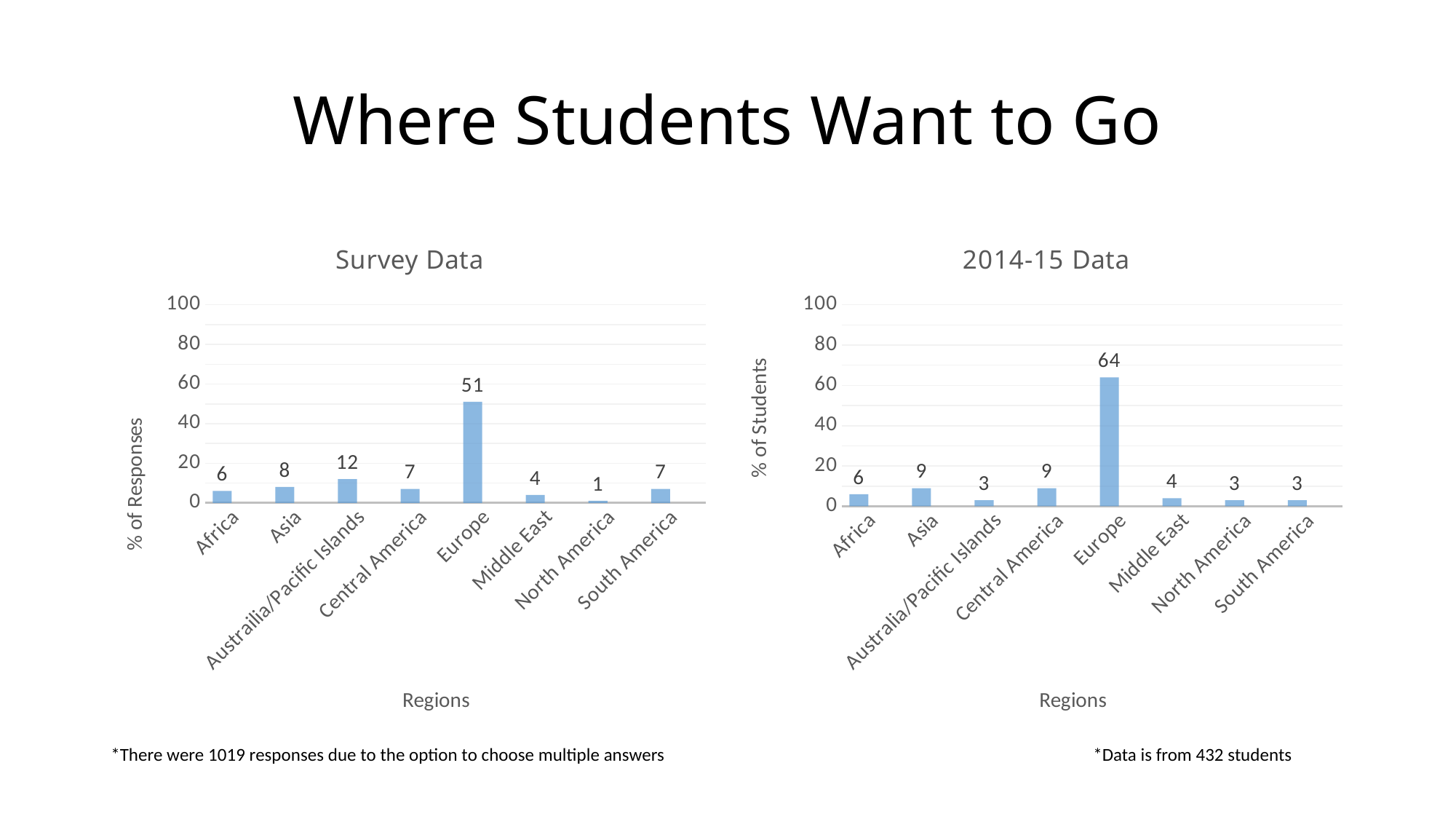
In the 2014-15 Data chart, which region has the highest value? Europe How many regions are shown in the Survey Data chart? 8 In the 2014-15 Data chart, is the value for Europe greater or less than 60? greater In the Survey Data chart, which is larger, the value for Asia or the value for Middle East? Asia In the Survey Data chart, which region has the lowest value? North America In the Survey Data chart, what is the difference between the values for Australia/Pacific Islands and Africa? 6 What kind of chart is the 2014-15 Data chart? bar chart In the 2014-15 Data chart, what is the value for Australia/Pacific Islands? 3 In the Survey Data chart, what is the value for Europe? 51 In the 2014-15 Data chart, what is the difference between the values for Europe and Asia? 55 What is the x-axis label of the 2014-15 Data chart? Regions What is the y-axis label of the Survey Data chart? % of Responses